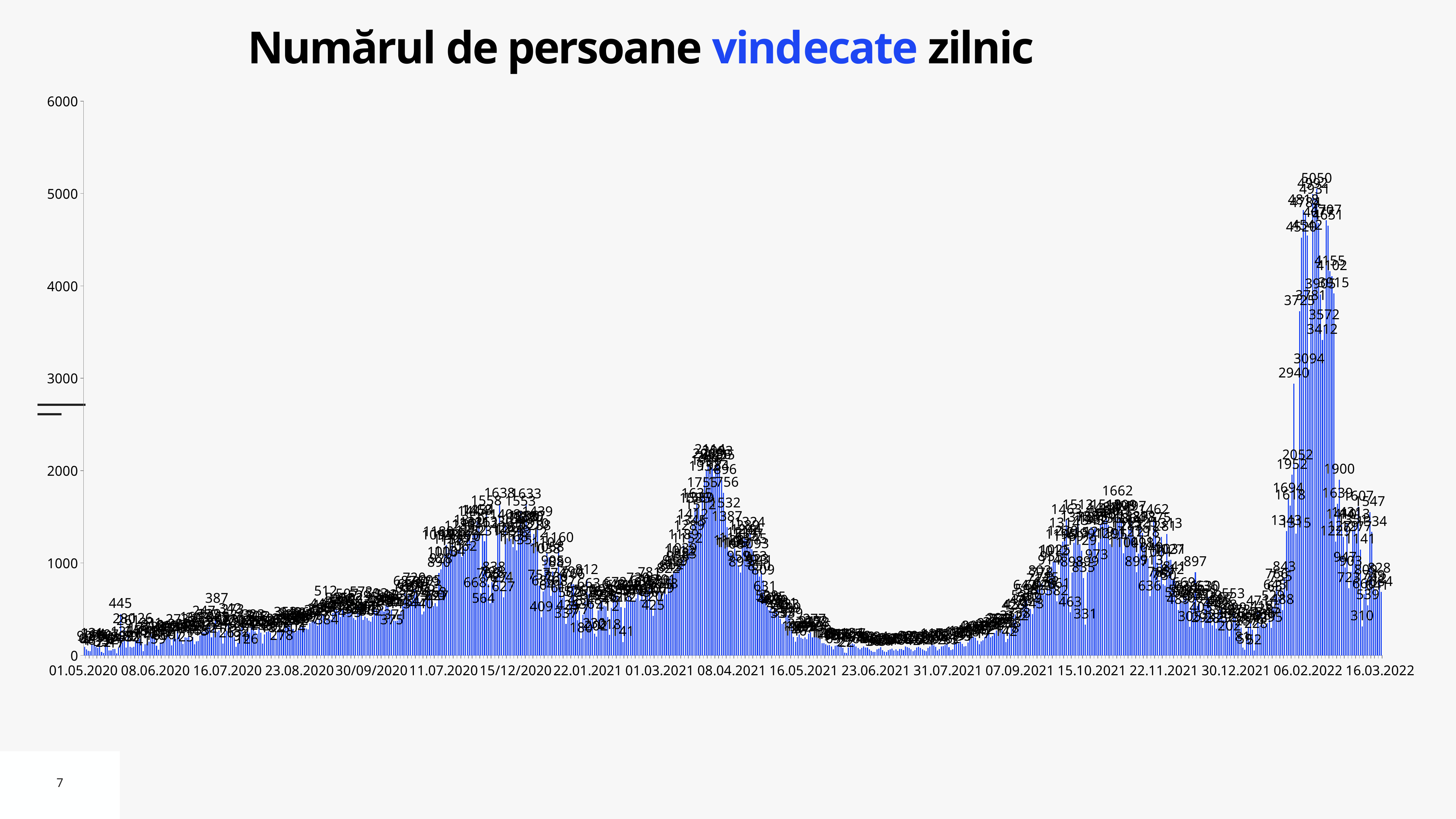
Do the values rise or fall between 23.06.2021 and 15.10.2021? rise Is the value for 01.05.2020 greater or less than 1000? less Which peak is higher: the one around 15/12/2020 or the one around 06.02.2022? 06.02.2022 What is the title of the chart? Numărul de persoane vindecate zilnic What is the maximum value shown on the vertical axis? 6000 What is the last date shown on the horizontal axis? 16.03.2022 What is the highest value labelled on the chart? 5050 Is the highest bar in February 2022 greater or less than 4000? greater Is the value for 23.06.2021 greater or less than 1000? less Do the values rise or fall between 08.04.2021 and 23.06.2021? fall What kind of chart is shown on the slide? bar chart What is the first date shown on the horizontal axis? 01.05.2020